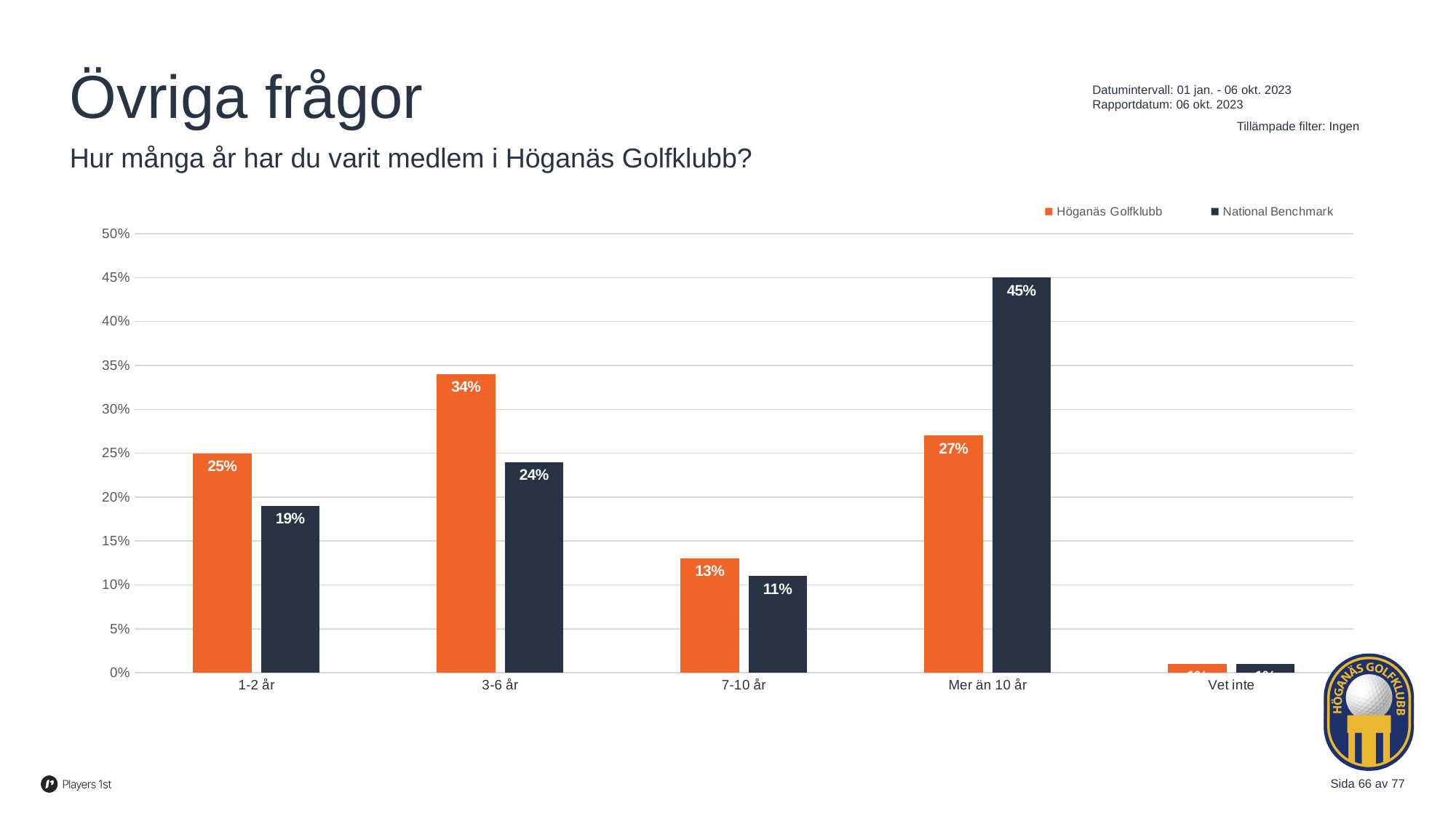
What is the difference between Höganäs Golfklubb and National Benchmark for 3-6 år? 10% What is the National Benchmark value for 7-10 år? 11% What is the Höganäs Golfklubb value for 1-2 år? 25% How many series does the legend list? 2 What is the value for Höganäs Golfklubb in the 3-6 år category? 34% What kind of chart is shown on the slide? Bar chart For 1-2 år, which series has the larger value, Höganäs Golfklubb or National Benchmark? Höganäs Golfklubb What is the National Benchmark value for the Mer än 10 år category? 45% Which category has the highest value for Höganäs Golfklubb? 3-6 år How many categories are shown on the x axis? 5 Which category has the highest value for National Benchmark? Mer än 10 år What is the difference between the National Benchmark and Höganäs Golfklubb values for Mer än 10 år? 18%